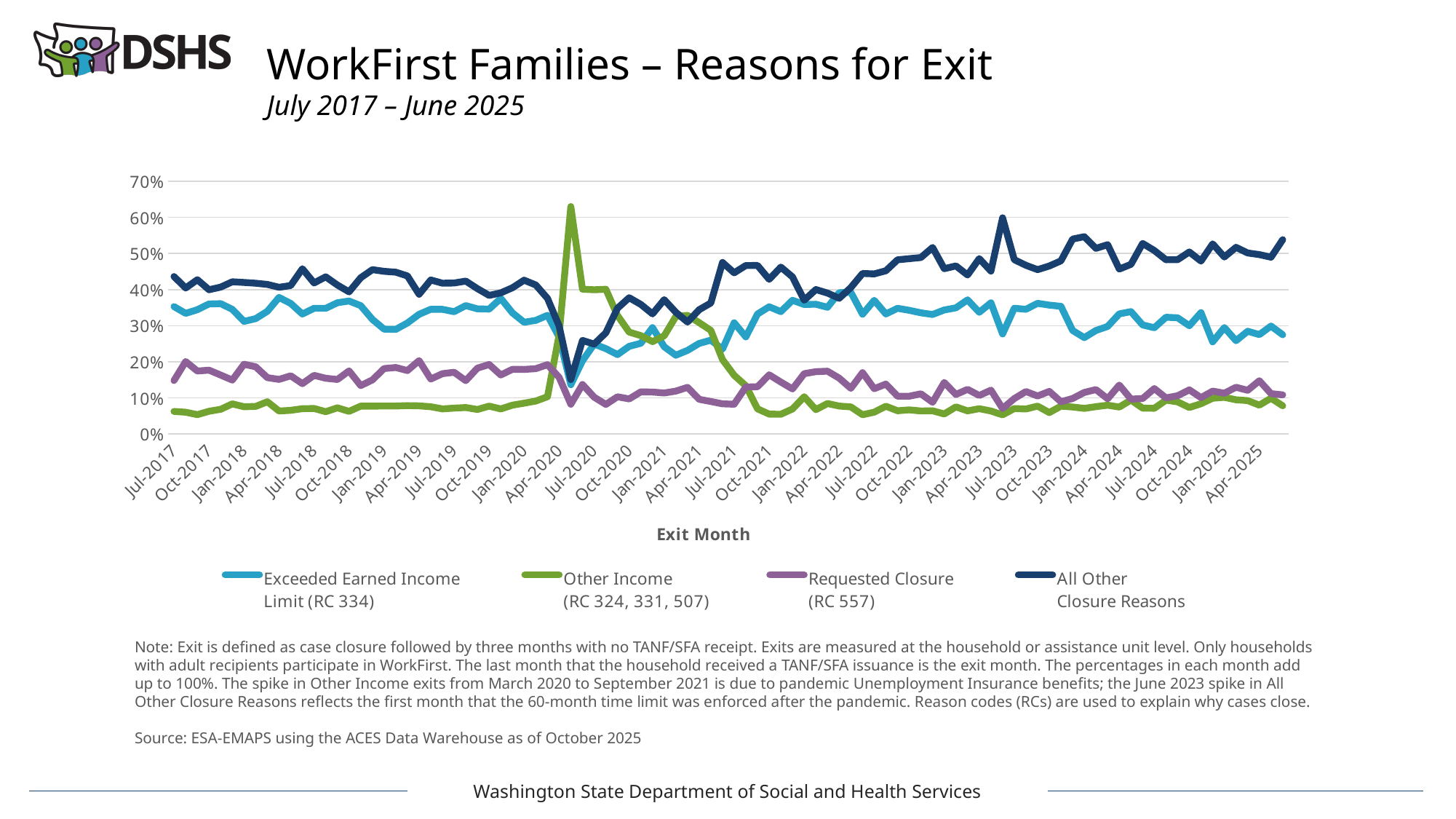
Which reason code is listed in the legend for Requested Closure? RC 557 Is the value for All Other Closure Reasons at Jul-2017 greater or less than 40%? greater At Jul-2017, which is larger: Exceeded Earned Income Limit or Requested Closure? Exceeded Earned Income Limit Does the All Other Closure Reasons series generally rise or fall from Jan-2021 to the end of the chart? rise At its peak in mid-2020, is the value for Other Income greater or less than 50%? greater Is the value for Exceeded Earned Income Limit at Jul-2017 greater or less than 30%? greater How many series does the legend list? 4 What is the title of the x axis? Exit Month Which series has the highest value at the last point on the chart (mid-2025)? All Other Closure Reasons Does the Requested Closure series generally rise or fall from Jul-2017 to the end of the chart? fall What kind of chart is shown on the slide? line chart